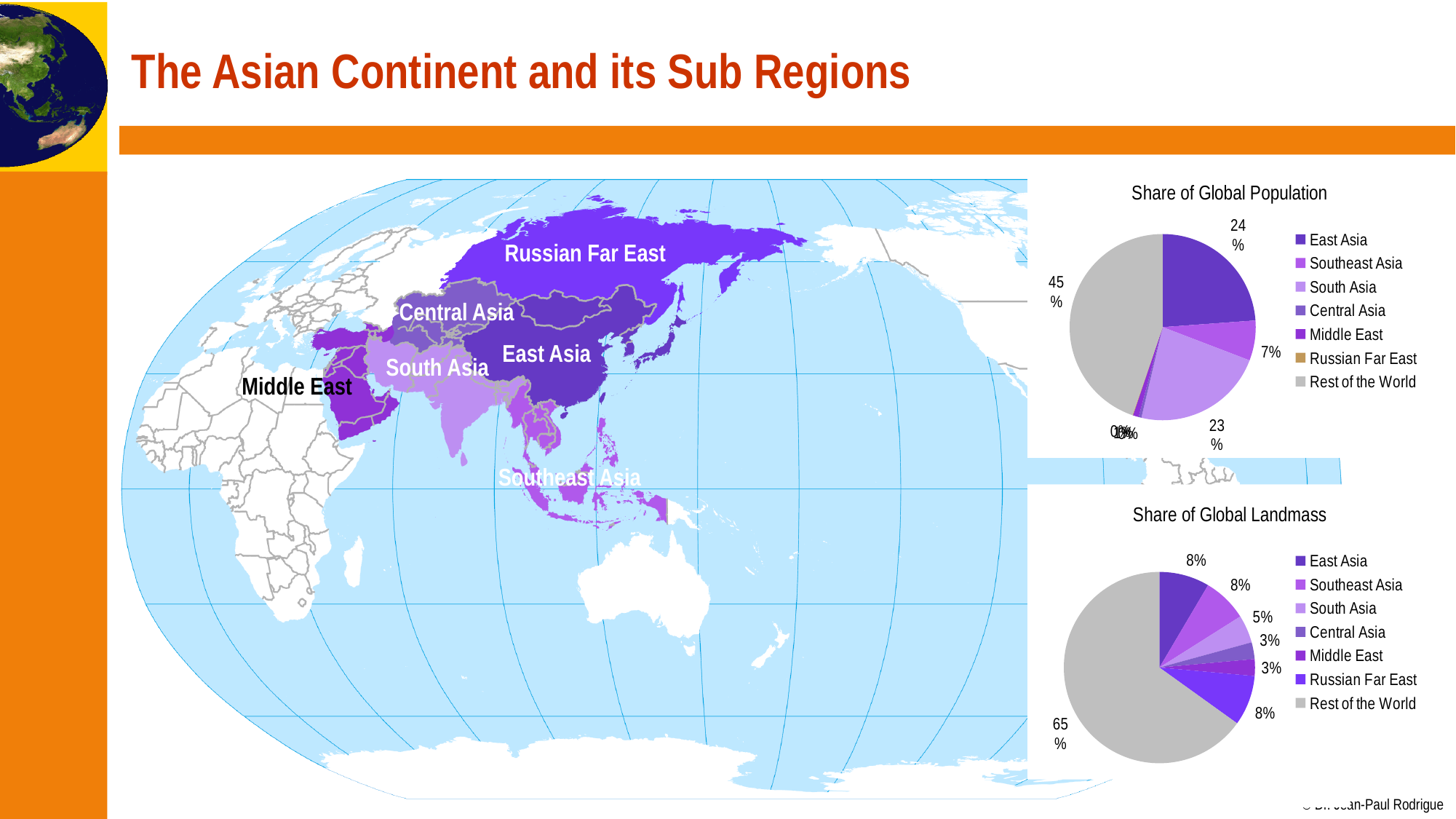
In the Share of Global Population chart, what is the difference between the East Asia and Southeast Asia shares? 17% In the Share of Global Landmass chart, what is the difference between the Rest of the World share and the Russian Far East share? 57% How many categories does the legend of the Share of Global Landmass chart list? 7 In the Share of Global Landmass chart, which is larger, the share for East Asia or the share for South Asia? East Asia In the Share of Global Landmass chart, what share does Central Asia have? 3% In the Share of Global Population chart, what share does South Asia have? 23% What kind of chart is the Share of Global Population chart? Pie chart In the Share of Global Population chart, what share does Southeast Asia have? 7% In the Share of Global Landmass chart, what share does Rest of the World have? 65% In the Share of Global Landmass chart, what share does South Asia have? 5% In the Share of Global Population chart, which category has the largest slice? Rest of the World In the Share of Global Population chart, what share does East Asia have? 24%